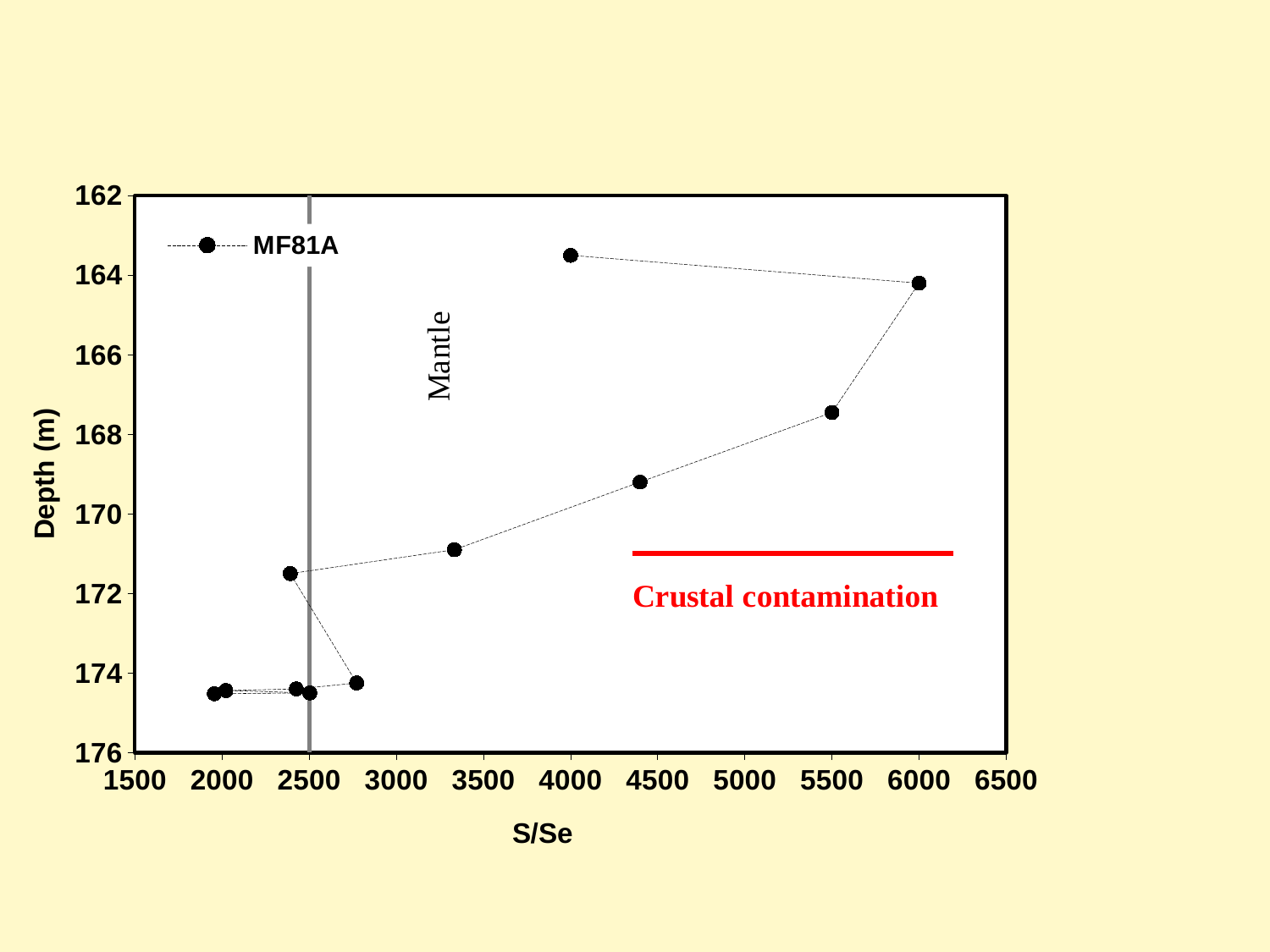
How many series does the legend list? 1 Is the S/Se value of the point near 171 m depth (around 3300) greater or less than 3000? greater Is the highest S/Se value plotted greater or less than 5500? greater Is the S/Se value of the point near 167.5 m depth greater or less than 5000? greater Which has the larger S/Se value: the point near 164 m depth or the point near 171.5 m depth? the point near 164 m depth What is the name of the series shown in the legend? MF81A Which has the larger S/Se value: the point near 167.5 m depth or the point near 169 m depth? the point near 167.5 m depth What kind of chart is shown on the slide? scatter plot with connected points What is the label of the x axis? S/Se